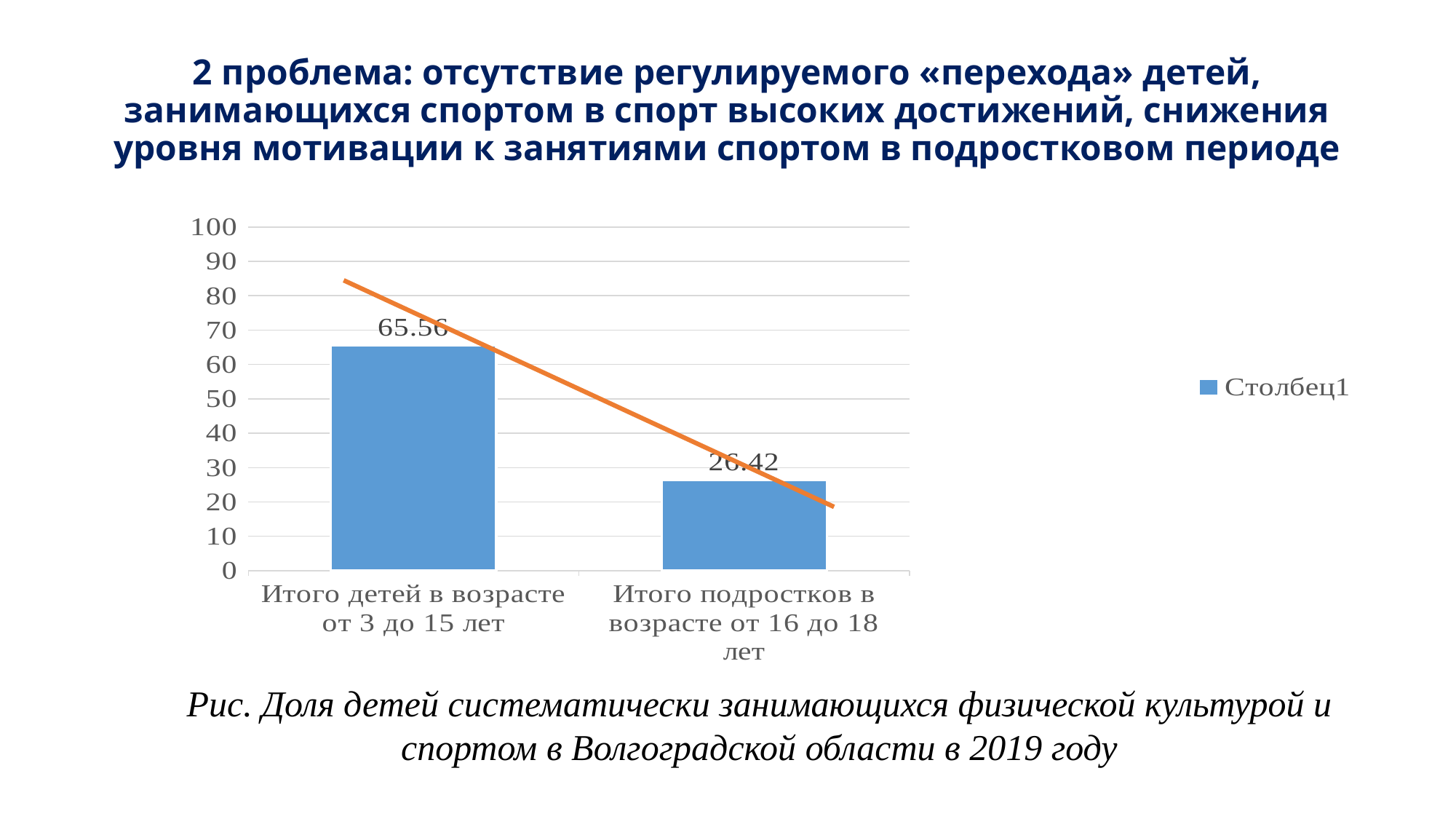
How many series does the legend list? 1 Which category has the highest value? Итого детей в возрасте от 3 до 15 лет What is the value for «Итого детей в возрасте от 3 до 15 лет»? 65.56 What is the value for «Итого подростков в возрасте от 16 до 18 лет»? 26.42 What is the difference between the value for children aged 3 to 15 and the value for teenagers aged 16 to 18? 39.14 Is the value for «Итого детей в возрасте от 3 до 15 лет» greater or less than 60? greater Which category has the lowest value? Итого подростков в возрасте от 16 до 18 лет Is the value for «Итого подростков в возрасте от 16 до 18 лет» greater or less than 30? less What is the name of the series in the legend? Столбец1 What kind of chart is shown on the slide? bar chart How many categories are shown on the x axis? 2 Which is larger: the value for children aged 3 to 15 or the value for teenagers aged 16 to 18? Итого детей в возрасте от 3 до 15 лет